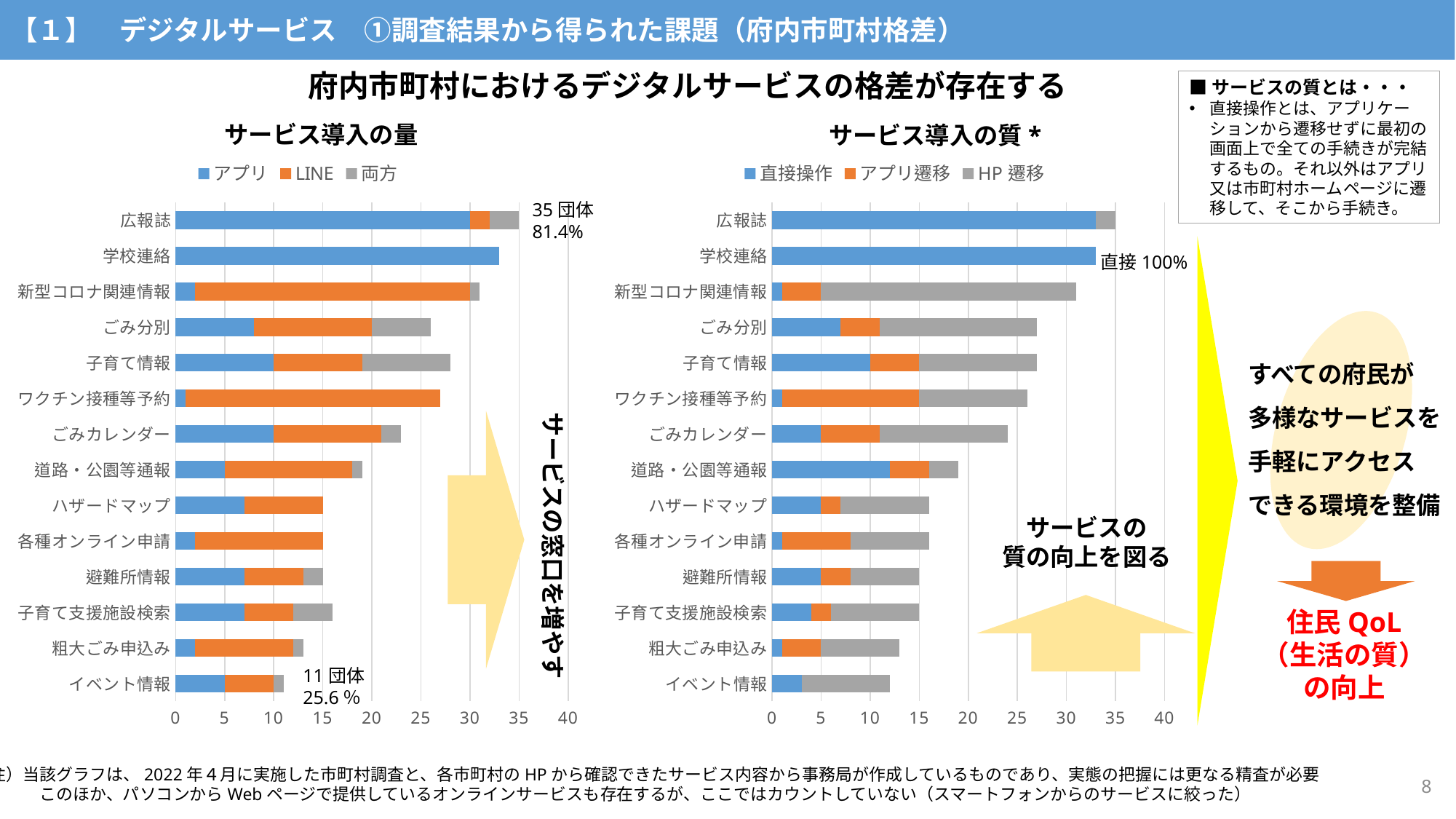
In the left chart (サービス導入の量), which category has the shortest total bar? イベント情報 In the left chart (サービス導入の量), do the total bar lengths generally increase or decrease from the top category to the bottom category? decrease What kind of chart is the left chart titled サービス導入の量? Stacked bar chart How many categories are plotted in the left chart (サービス導入の量)? 14 In the left chart (サービス導入の量), which has the longer total bar: ごみ分別 or ハザードマップ? ごみ分別 In the right chart (サービス導入の質＊), what percentage of 直接操作 is labelled for 学校連絡? 100% In the left chart (サービス導入の量), what percentage is labelled for イベント情報? 25.6％ In the right chart (サービス導入の質＊), is the total bar for ハザードマップ greater or less than 20? less In the left chart (サービス導入の量), how many 団体 are labelled for 広報誌? 35 団体 In the left chart (サービス導入の量), which category has the longest total bar? 広報誌 How many series does the legend of the left chart (サービス導入の量) list? 3 What are the legend entries of the right chart (サービス導入の質＊)? 直接操作, アプリ遷移, HP 遷移